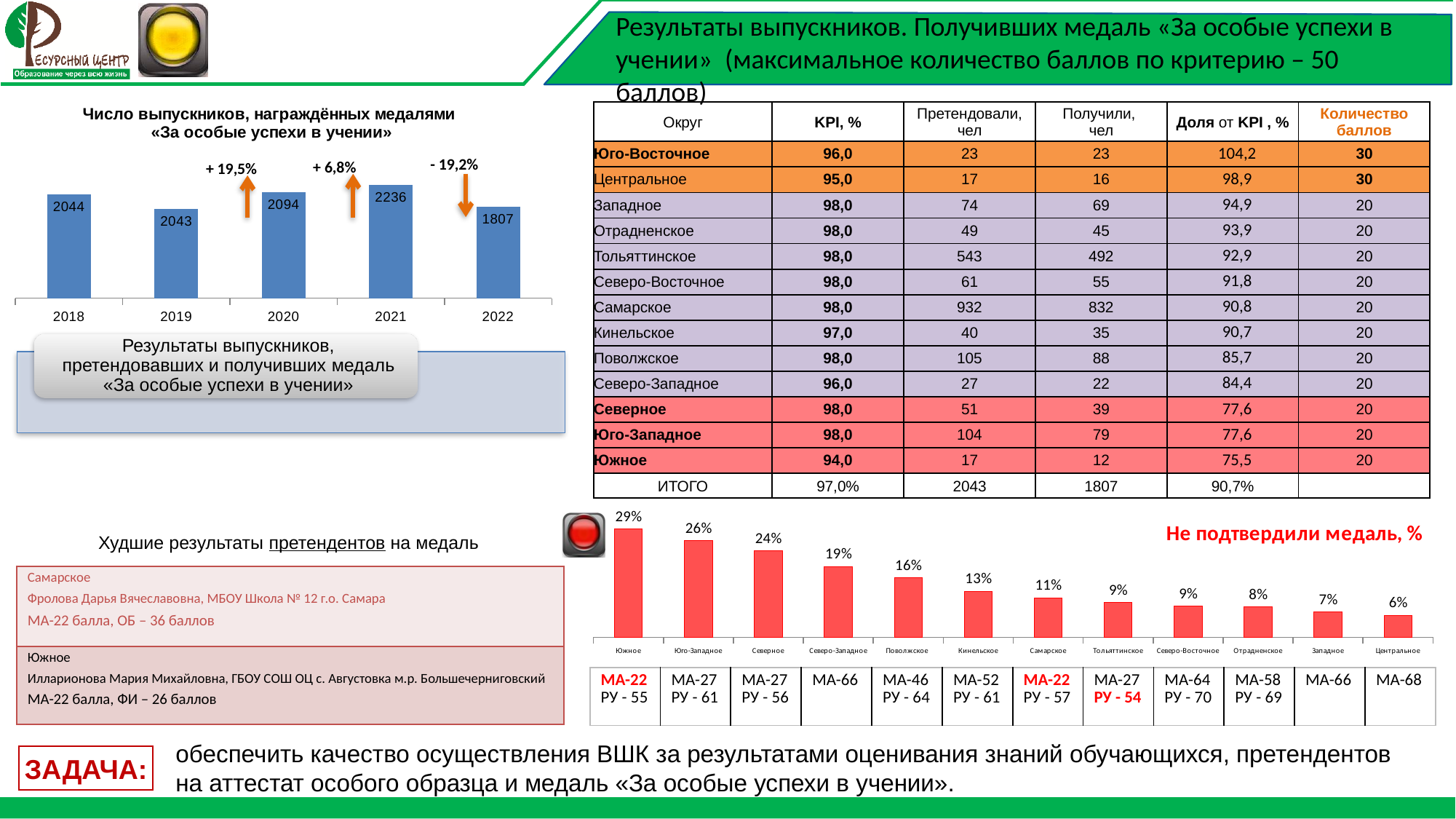
In the chart «Число выпускников, награждённых медалями», what is the difference between the values for 2021 and 2022? 429 In the chart «Не подтвердили медаль, %», which district has the lowest value? Центральное In the chart «Не подтвердили медаль, %», what is the value for Поволжское? 16% What type of chart is «Число выпускников, награждённых медалями»? bar chart In the chart «Число выпускников, награждённых медалями», what is the value for 2022? 1807 In the chart «Не подтвердили медаль, %», which is larger: Северное or Кинельское? Северное In the chart «Не подтвердили медаль, %», what is the value for Южное? 29% In the chart «Число выпускников, награждённых медалями», which year has the highest value? 2021 In the chart «Не подтвердили медаль, %», do the values rise or fall from left to right along the x axis? fall In the chart «Число выпускников, награждённых медалями», what is the value for 2021? 2236 In the chart «Число выпускников, награждённых медалями», how many years are shown on the x axis? 5